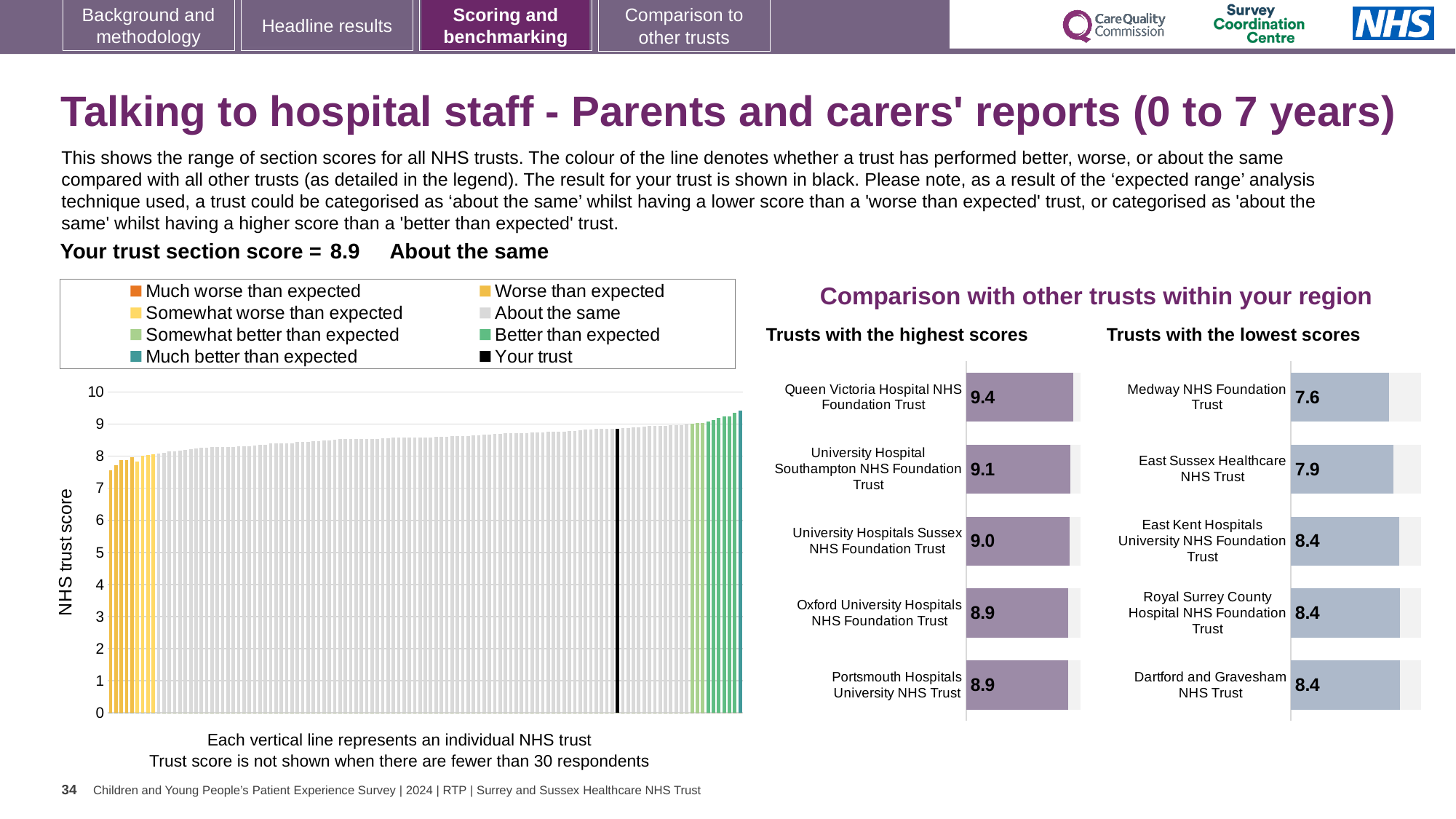
In the 'Trusts with the highest scores' chart, what is the score for Queen Victoria Hospital NHS Foundation Trust? 9.4 How many trusts are listed in the 'Trusts with the lowest scores' chart? 5 How many entries does the legend of the left-hand NHS trust score chart list? 8 In the 'Trusts with the highest scores' chart, what is the difference between the scores of Queen Victoria Hospital NHS Foundation Trust and University Hospital Southampton NHS Foundation Trust? 0.3 Which is higher: the score for University Hospital Southampton NHS Foundation Trust in the highest scores chart or the score for East Sussex Healthcare NHS Trust in the lowest scores chart? University Hospital Southampton NHS Foundation Trust In the 'Trusts with the lowest scores' chart, what is the score for Medway NHS Foundation Trust? 7.6 In the 'Trusts with the lowest scores' chart, what is the difference between the scores of East Kent Hospitals University NHS Foundation Trust and Medway NHS Foundation Trust? 0.8 In the 'Trusts with the highest scores' chart, which trust has the highest score? Queen Victoria Hospital NHS Foundation Trust What type of chart is the left-hand chart showing NHS trust scores? Bar chart In the 'Trusts with the lowest scores' chart, what is the score for East Sussex Healthcare NHS Trust? 7.9 In the 'Trusts with the highest scores' chart, what is the score for University Hospitals Sussex NHS Foundation Trust? 9.0 In the 'Trusts with the lowest scores' chart, which trust has the lowest score? Medway NHS Foundation Trust